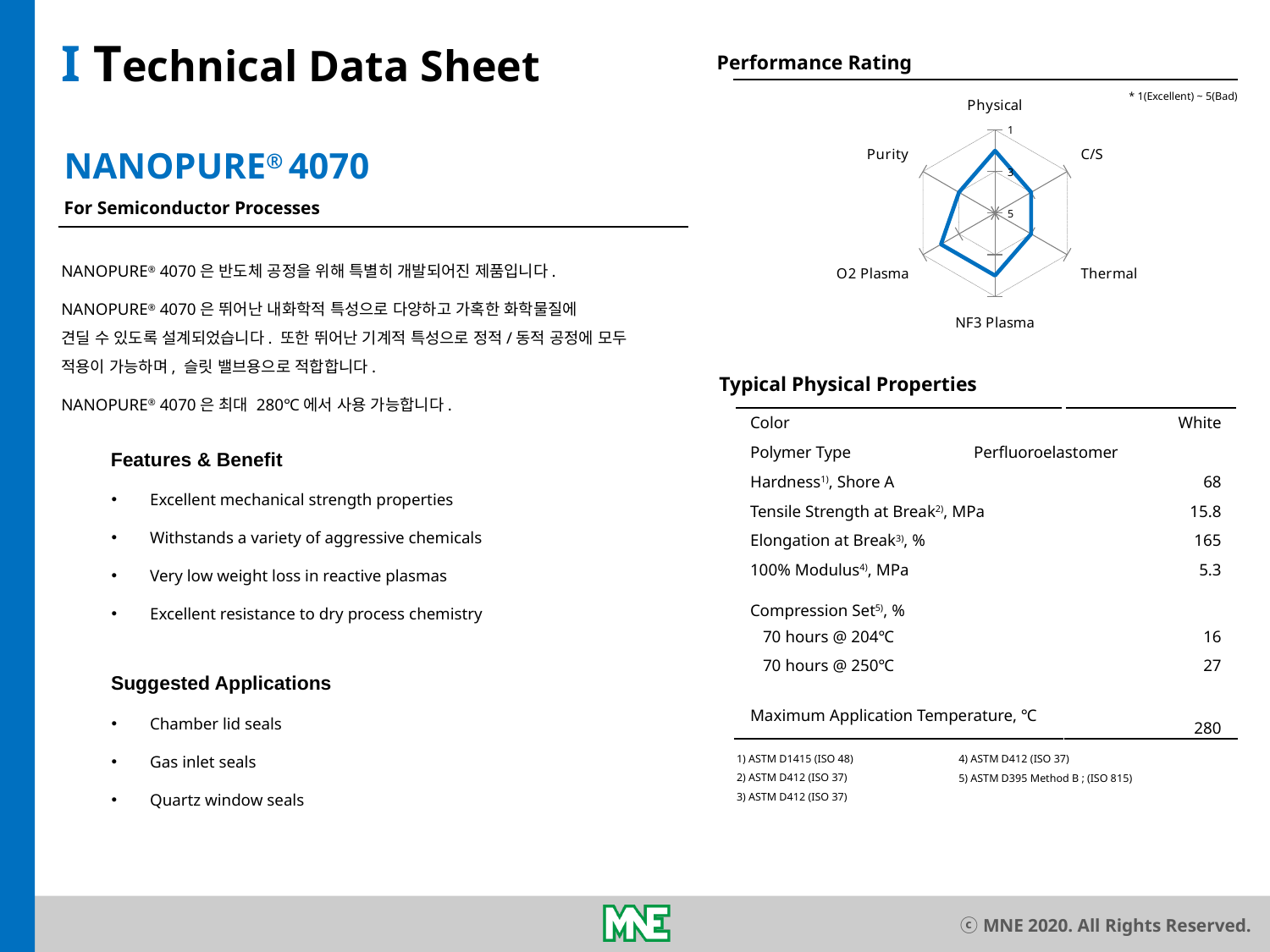
What kind of chart is shown under the "Performance Rating" heading? Radar chart In the Performance Rating chart, is the value for Physical greater or less than 3? less According to the note on the Performance Rating chart, which rating value means Excellent? 1 How many categories (axes) does the Performance Rating radar chart have? 6 In the Performance Rating chart, is the value for NF3 Plasma greater or less than 3? less What is the title of the chart on the slide? Performance Rating In the Performance Rating chart, is the value for O2 Plasma greater or less than 3? less Which category is plotted at the top of the Performance Rating radar chart? Physical